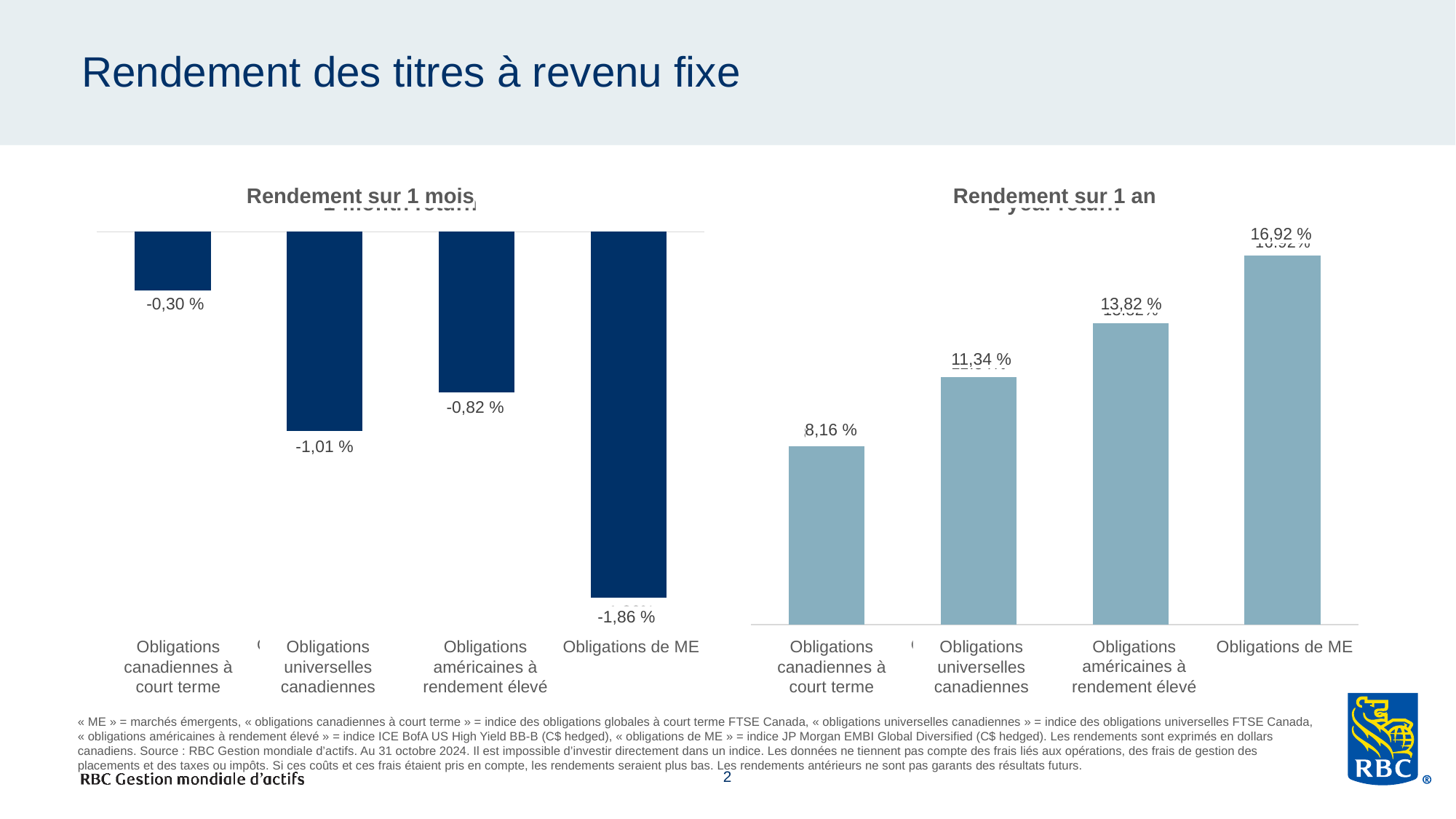
What kind of chart is the 'Rendement sur 1 an' chart? Bar chart In the 'Rendement sur 1 an' chart, what is the difference between Obligations de ME and Obligations canadiennes à court terme? 8,76 % How many categories are shown in the 'Rendement sur 1 mois' chart? 4 In the 'Rendement sur 1 mois' chart, what is the value for Obligations de ME? -1,86 % In the 'Rendement sur 1 mois' chart, which category has the lowest value? Obligations de ME In the 'Rendement sur 1 an' chart, which category has the highest value? Obligations de ME In the 'Rendement sur 1 mois' chart, what is the difference between Obligations canadiennes à court terme and Obligations universelles canadiennes? 0,71 % In the 'Rendement sur 1 an' chart, what is the value for Obligations universelles canadiennes? 11,34 % In the 'Rendement sur 1 an' chart, which category has the lowest value? Obligations canadiennes à court terme In the 'Rendement sur 1 an' chart, do the values rise or fall from left to right? Rise In the 'Rendement sur 1 an' chart, which is larger: Obligations américaines à rendement élevé or Obligations universelles canadiennes? Obligations américaines à rendement élevé In the 'Rendement sur 1 mois' chart, what is the value for Obligations américaines à rendement élevé? -0,82 %